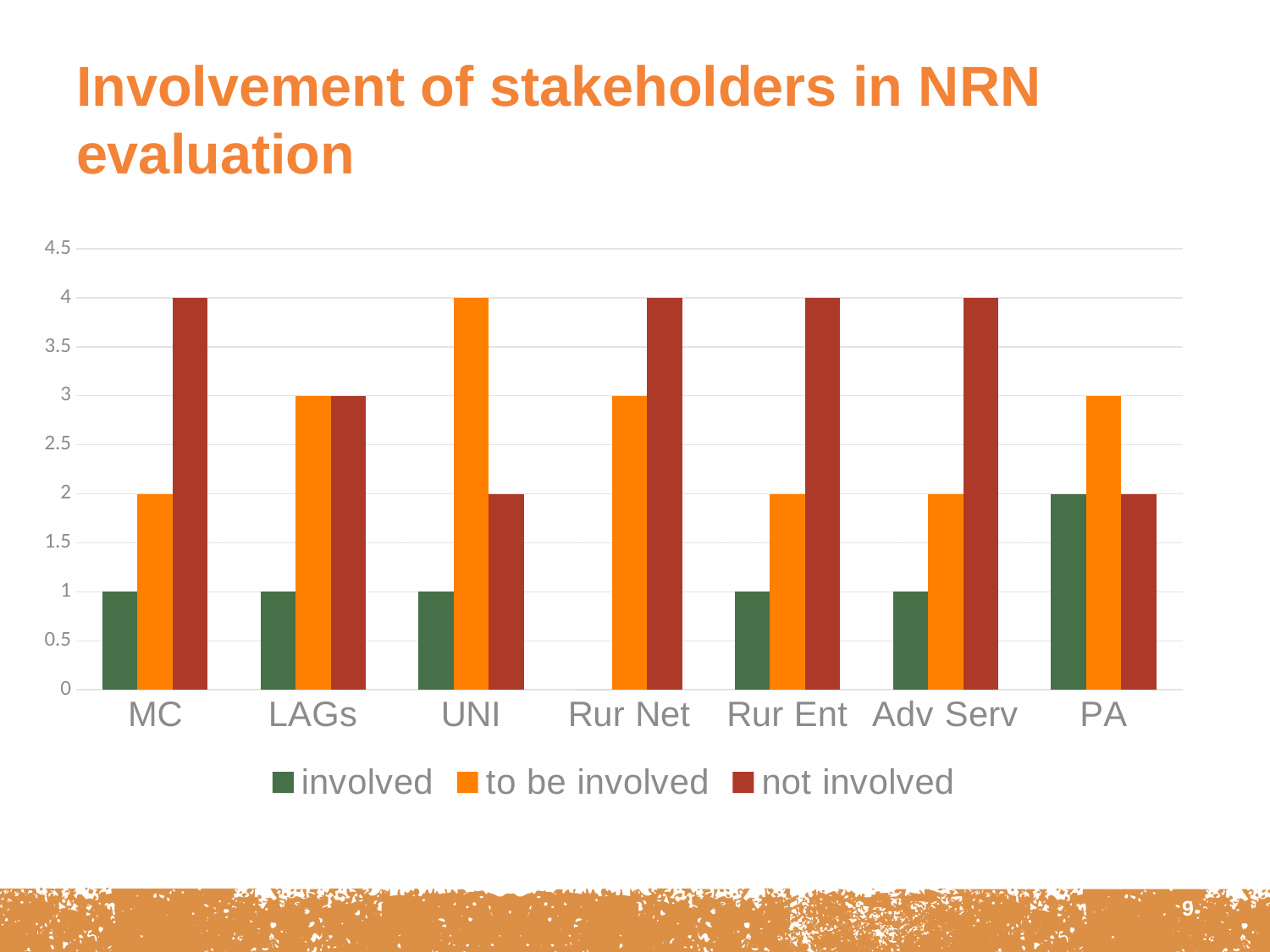
What is the difference between the 'to be involved' and 'not involved' values for UNI? 2 What is the value of 'involved' for PA? 2 What kind of chart is shown on the slide? bar chart What are the three legend entries of the chart? involved, to be involved, not involved What is the value of 'to be involved' for UNI? 4 Which is larger: the 'not involved' value for MC or for UNI? MC How many stakeholder categories are shown on the x axis? 7 What is the value of 'not involved' for MC? 4 How many series does the legend list? 3 Which category has the highest 'to be involved' value? UNI What is the value of 'to be involved' for Rur Net? 3 Which category has the highest 'involved' value? PA